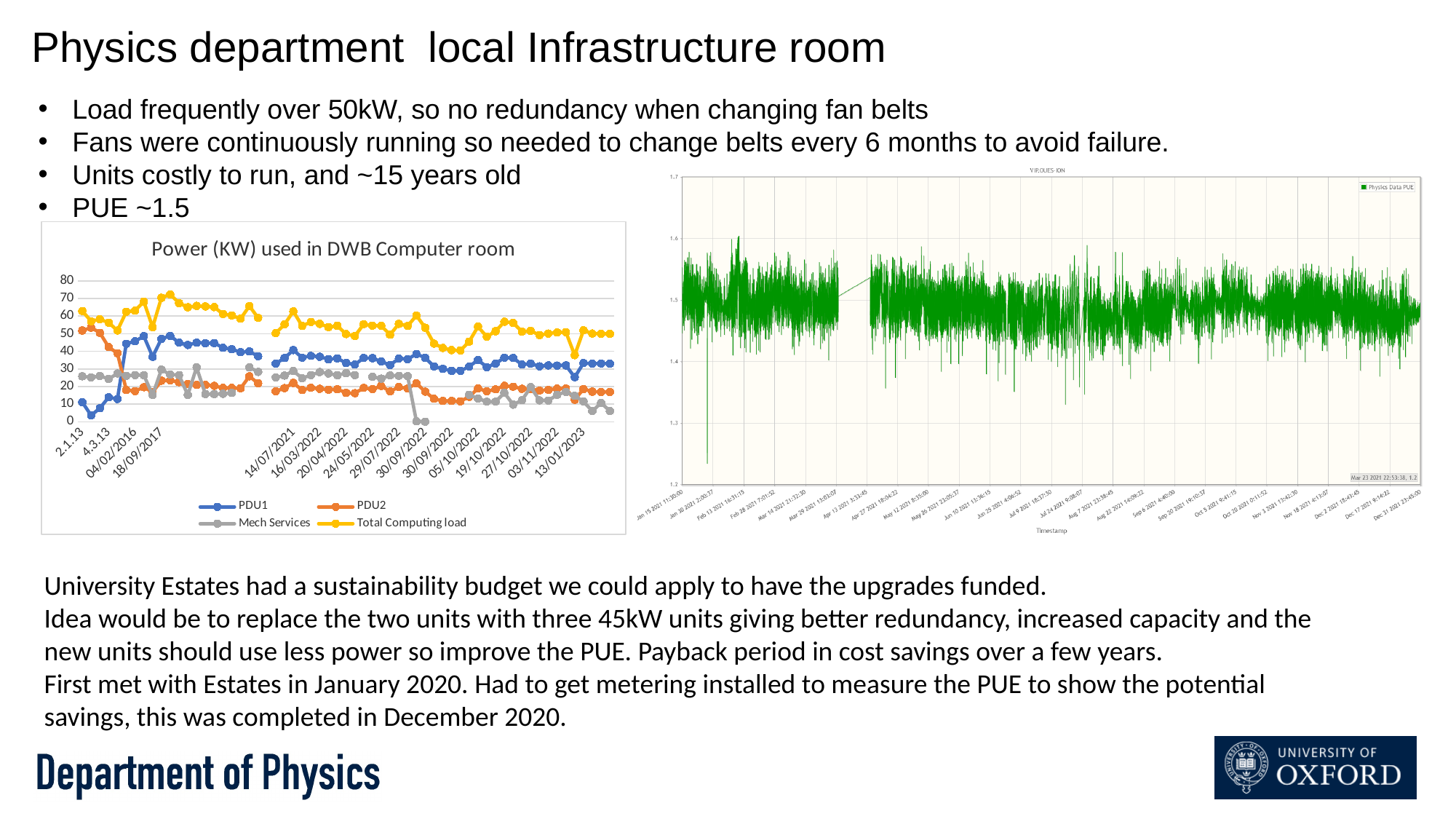
In the 'Power (KW) used in DWB Computer room' chart, is the value of PDU1 at 2.1.13 greater or less than 20? less In the chart on the right, is the lowest dip in the PUE line (near the start of the period) greater or less than 1.3? less In the 'Power (KW) used in DWB Computer room' chart, is the value of Mech Services at 30/09/2022 greater or less than 10? less In the 'Power (KW) used in DWB Computer room' chart, which is larger at 13/01/2023, PDU1 or PDU2? PDU1 In the 'Power (KW) used in DWB Computer room' chart, which series has the highest values across the whole period? Total Computing load What is the legend entry of the chart on the right? Physics Data PUE What kind of chart is the 'Power (KW) used in DWB Computer room' chart? line chart How many series does the legend of the chart on the right list? 1 In the 'Power (KW) used in DWB Computer room' chart, what colour is the Total Computing load line? yellow How many series does the legend of the 'Power (KW) used in DWB Computer room' chart list? 4 In the 'Power (KW) used in DWB Computer room' chart, which series has the lowest value at 13/01/2023? Mech Services